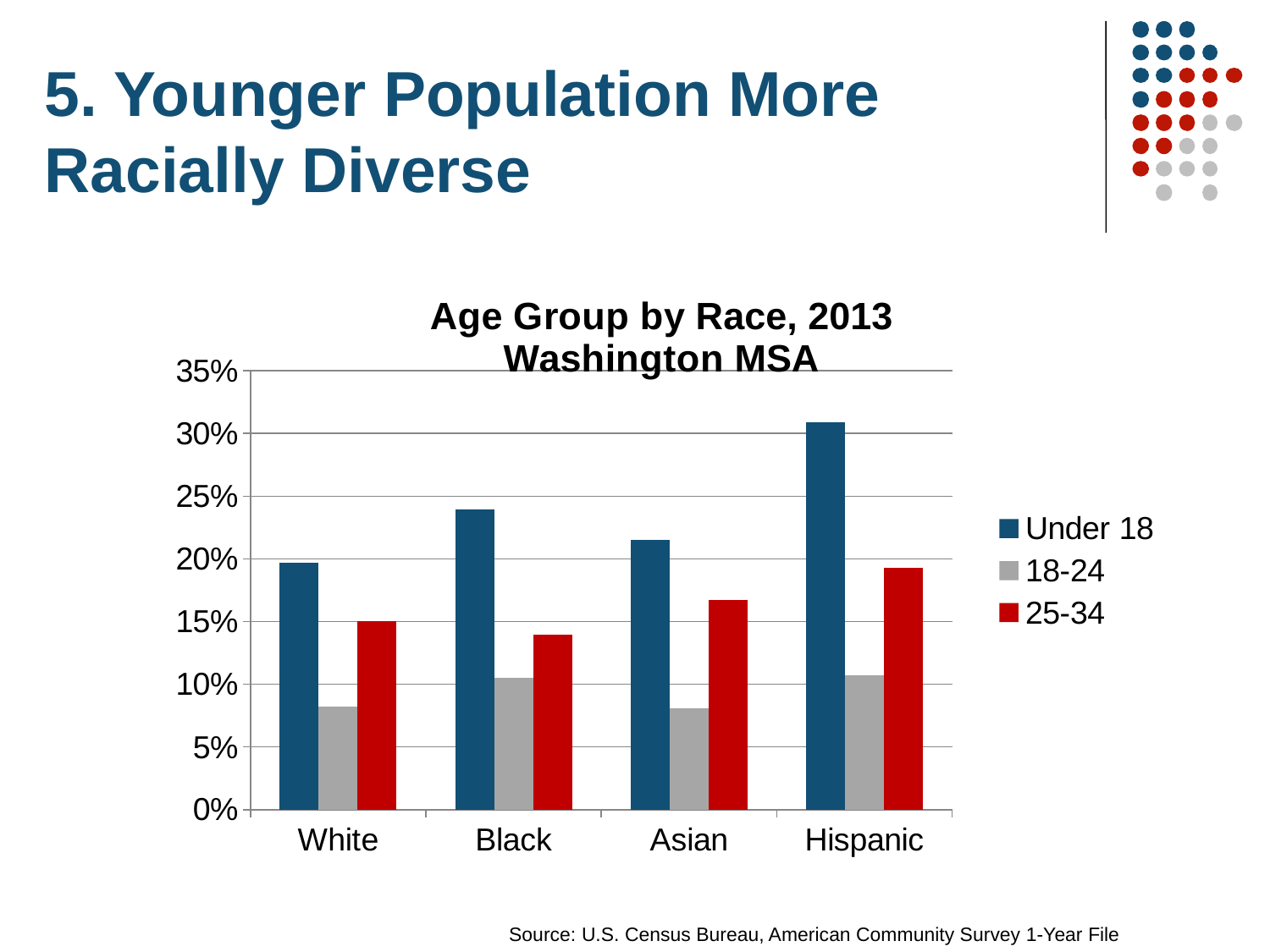
Which racial group has the highest 25-34 share? Hispanic Is the 25-34 value for Asian greater or less than 15%? greater Which racial group has the highest Under 18 share? Hispanic Which is larger, the Under 18 value for Black or the Under 18 value for Asian? Black How many series does the legend list? 3 How many racial categories are shown on the x axis? 4 Which is larger, the 25-34 value for Asian or the 25-34 value for White? Asian Is the Under 18 value for Hispanic greater or less than 25%? greater What kind of chart is shown on the slide? bar chart Is the 18-24 value for White greater or less than 10%? less Which racial group has the lowest Under 18 share? White What is the title of the chart? Age Group by Race, 2013 Washington MSA